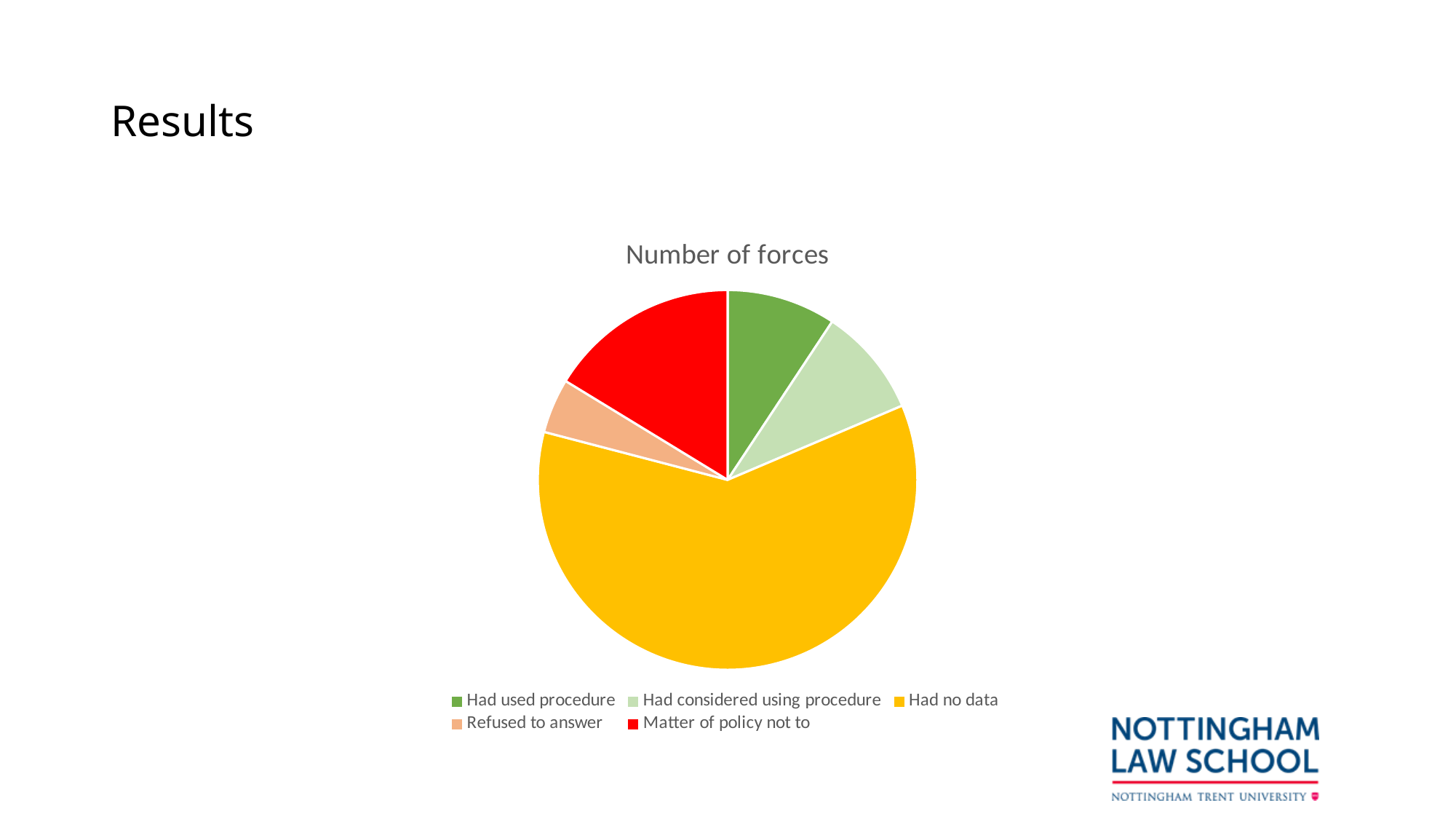
Which slice is larger: 'Refused to answer' or 'Had considered using procedure'? Had considered using procedure Does the 'Had no data' slice take up more or less than half of the pie? more Which category has the largest slice of the pie? Had no data Which slice is larger: 'Matter of policy not to' or 'Had used procedure'? Matter of policy not to Which category is shown in red in the pie chart? Matter of policy not to What kind of chart is shown on the slide? pie chart Which category has the smallest slice of the pie? Refused to answer What is the title of the chart? Number of forces How many categories (slices) does the pie chart have? 5